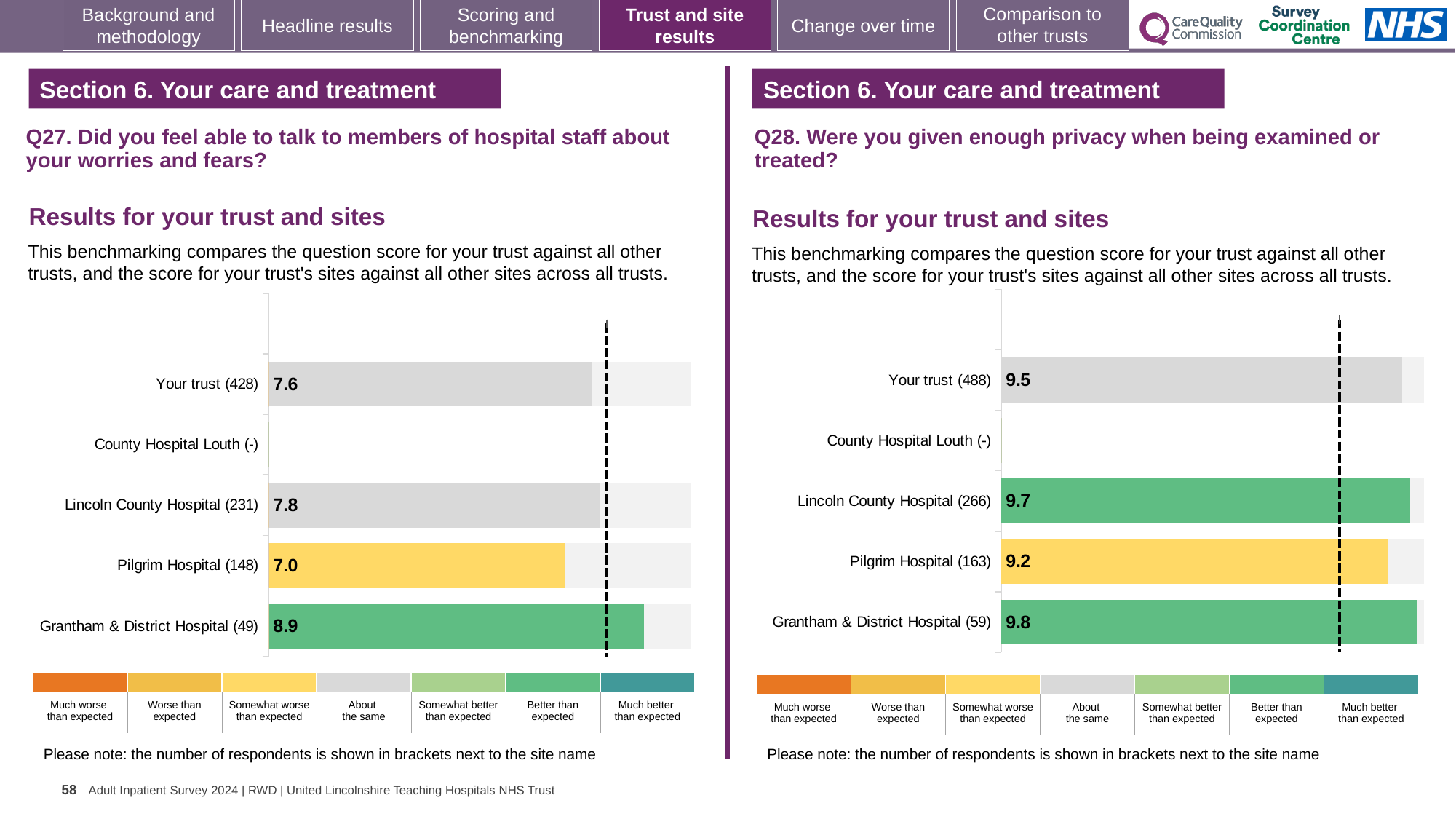
In the Q28 chart on the right, which site has the highest score? Grantham & District Hospital (59) In the Q27 chart on the left, what is the score for Pilgrim Hospital (148)? 7.0 In the Q27 chart on the left, what is the difference between the scores for Grantham & District Hospital and Pilgrim Hospital? 1.9 In the Q28 chart on the right, what is the score for Your trust (488)? 9.5 In the Q27 chart on the left, which site has the highest score? Grantham & District Hospital (49) What type of chart is used for the Q27 results on the left? Bar chart In the Q27 chart on the left, what is the score for Your trust (428)? 7.6 How many categories (trust and sites) are listed on the Q28 chart on the right? 5 In the Q28 chart on the right, what is the difference between the scores for Grantham & District Hospital and Pilgrim Hospital? 0.6 In the Q27 chart on the left, which has the larger score: Lincoln County Hospital or Your trust? Lincoln County Hospital In the Q28 chart on the right, what is the score for Lincoln County Hospital (266)? 9.7 In the Q27 chart on the left, which site with a plotted score has the lowest score? Pilgrim Hospital (148)